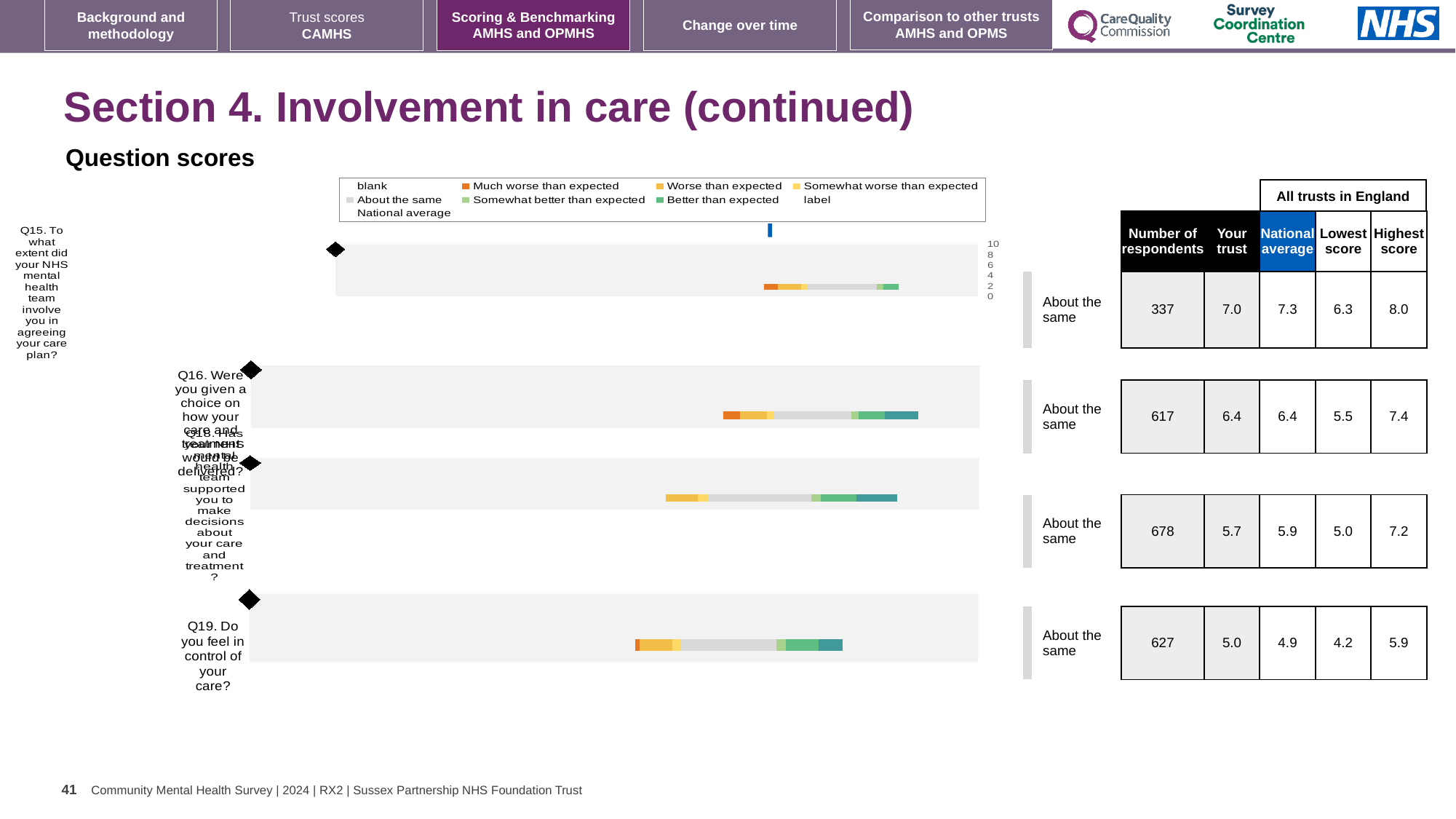
What is the lowest score among all trusts in England for Q18? 5.0 What is the national average score for Q15? 7.3 For Q19, which is larger: the 'Your trust' score or the national average? Your trust What is the highest score among all trusts in England for Q19 (control of your care)? 5.9 Which question has the highest 'Your trust' score? Q15 What kind of chart is used to show the question scores on this slide? bar chart How many questions (Q15, Q16, Q18, Q19) are plotted on the slide? 4 What is the 'Your trust' score for Q15 (involvement in agreeing your care plan)? 7.0 What is the difference between the national average and the 'Your trust' score for Q15? 0.3 How many respondents answered Q16 (choice on how care and treatment would be delivered)? 617 What benchmark category is shown for Q18? About the same Which question has the lowest 'Your trust' score? Q19